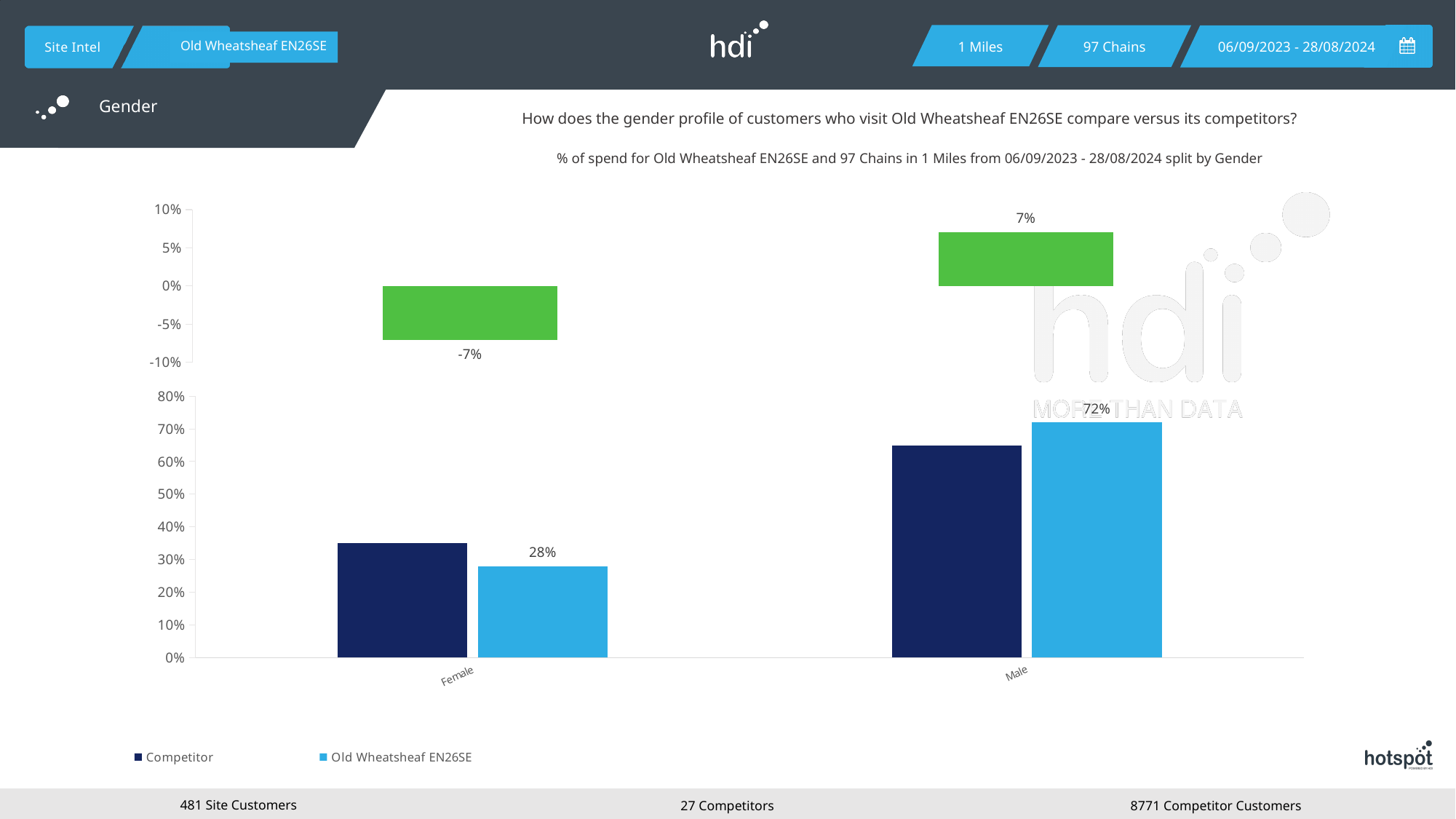
In the bottom chart, what is the % of spend for Old Wheatsheaf EN26SE for Male customers? 72% In the top chart, what is the value shown for Female? -7% In the bottom chart, is the Competitor value for Male greater or less than 70%? less In the bottom chart, for Female customers, which is larger: the Competitor value or the Old Wheatsheaf EN26SE value? Competitor How many series does the legend of the bottom chart list? 2 In the bottom chart, what is the % of spend for Old Wheatsheaf EN26SE for Female customers? 28% In the bottom chart, which gender has the higher % of spend for Old Wheatsheaf EN26SE? Male In the bottom chart, is the Competitor value for Female greater or less than 30%? greater In the top chart, what is the value shown for Male? 7% In the bottom chart, what is the difference between the Old Wheatsheaf EN26SE values for Male and Female? 44% In the bottom chart, for Male customers, which is larger: the Competitor value or the Old Wheatsheaf EN26SE value? Old Wheatsheaf EN26SE What type of chart is the bottom chart? Bar chart